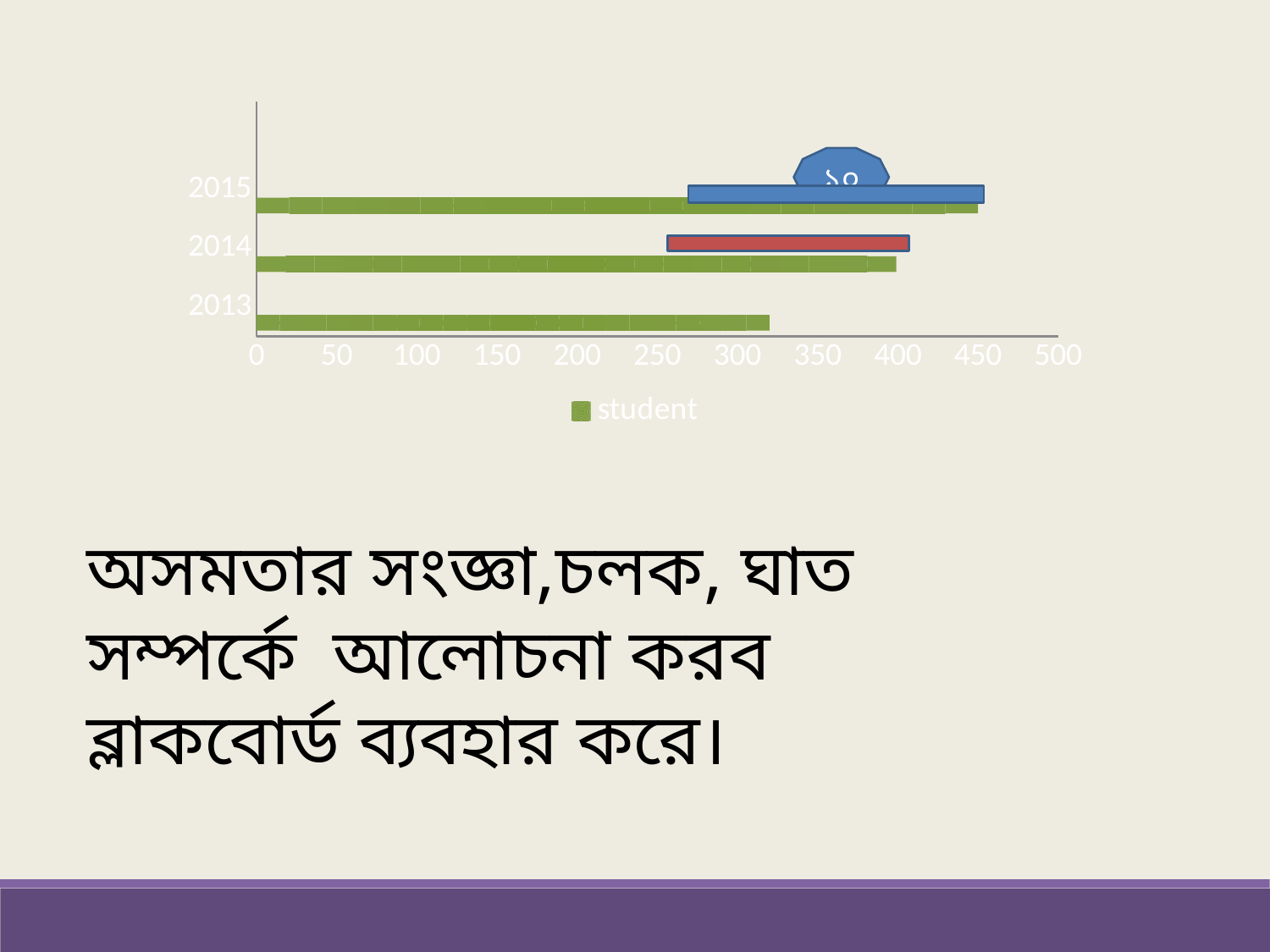
Is the student value for 2014 greater or less than 350? greater Do the student values rise or fall from 2013 to 2015? rise Is the student value for 2013 greater or less than 350? less Which year has the lowest student value? 2013 Which year has the highest student value? 2015 Is the student value for 2013 greater or less than 300? greater Which year has a larger student value, 2013 or 2014? 2014 How many series does the chart legend list? 1 What kind of chart is shown on the slide? bar chart What is the name of the series shown in the chart legend? student How many categories (years) are plotted in the chart? 3